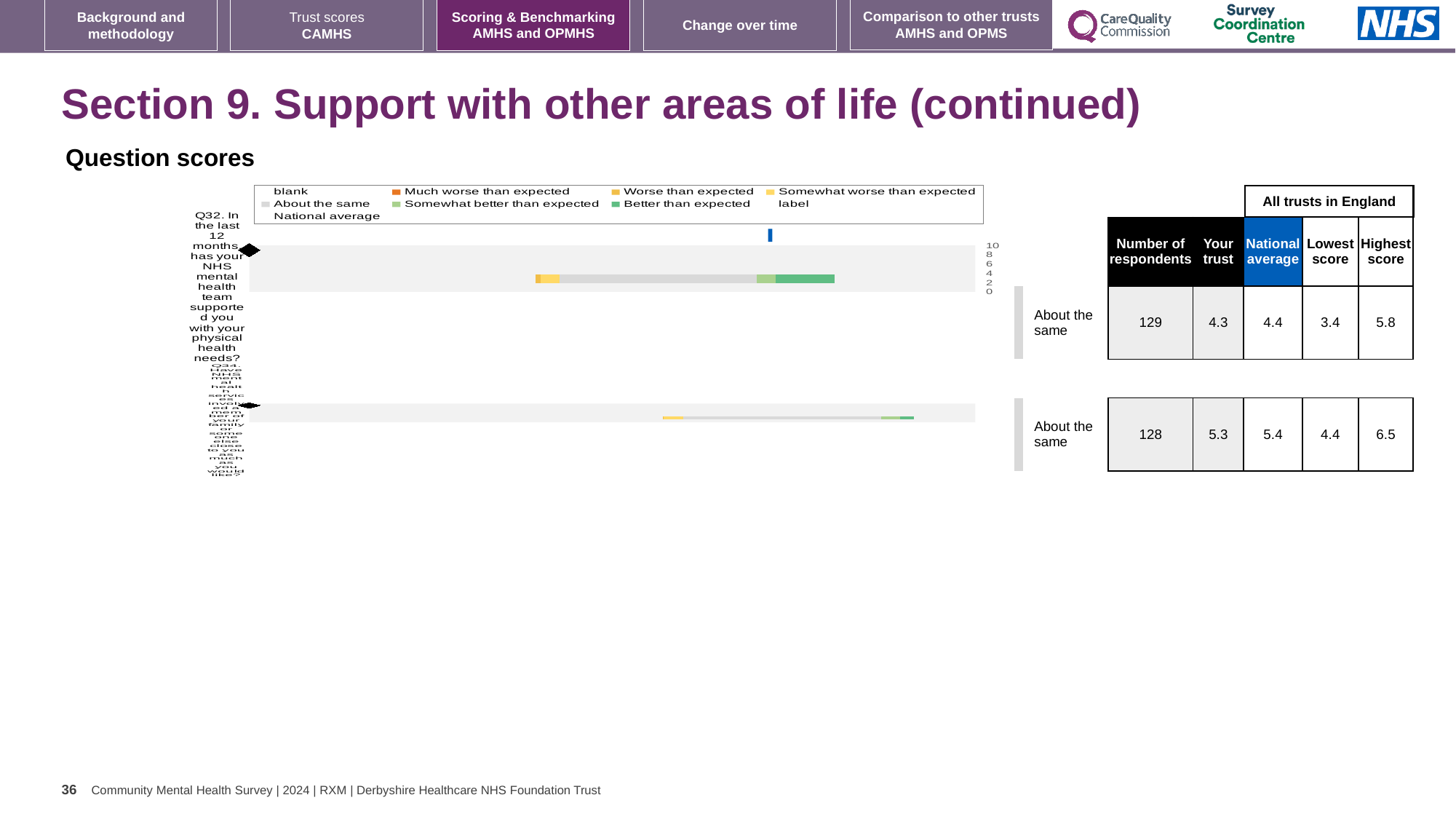
What is the 'Your trust' score for Q34 (involving family or someone close)? 5.3 What is the difference between the highest and lowest trust scores for Q34? 2.1 What kind of chart is used to show the question scores on this slide? Bar chart How many survey questions are plotted in the question scores chart? 2 How many respondents answered Q32? 129 What is the highest score across all trusts in England for Q34? 6.5 What benchmark category label is shown next to both Q32 and Q34 in the chart? About the same What is the 'Your trust' score for Q32 (support with physical health needs)? 4.3 For Q32, which is larger: the trust's score or the national average? National average What is the difference between the highest and lowest trust scores for Q32? 2.4 What is the national average score for Q32? 4.4 Which of the two plotted questions has the higher 'Your trust' score? Q34